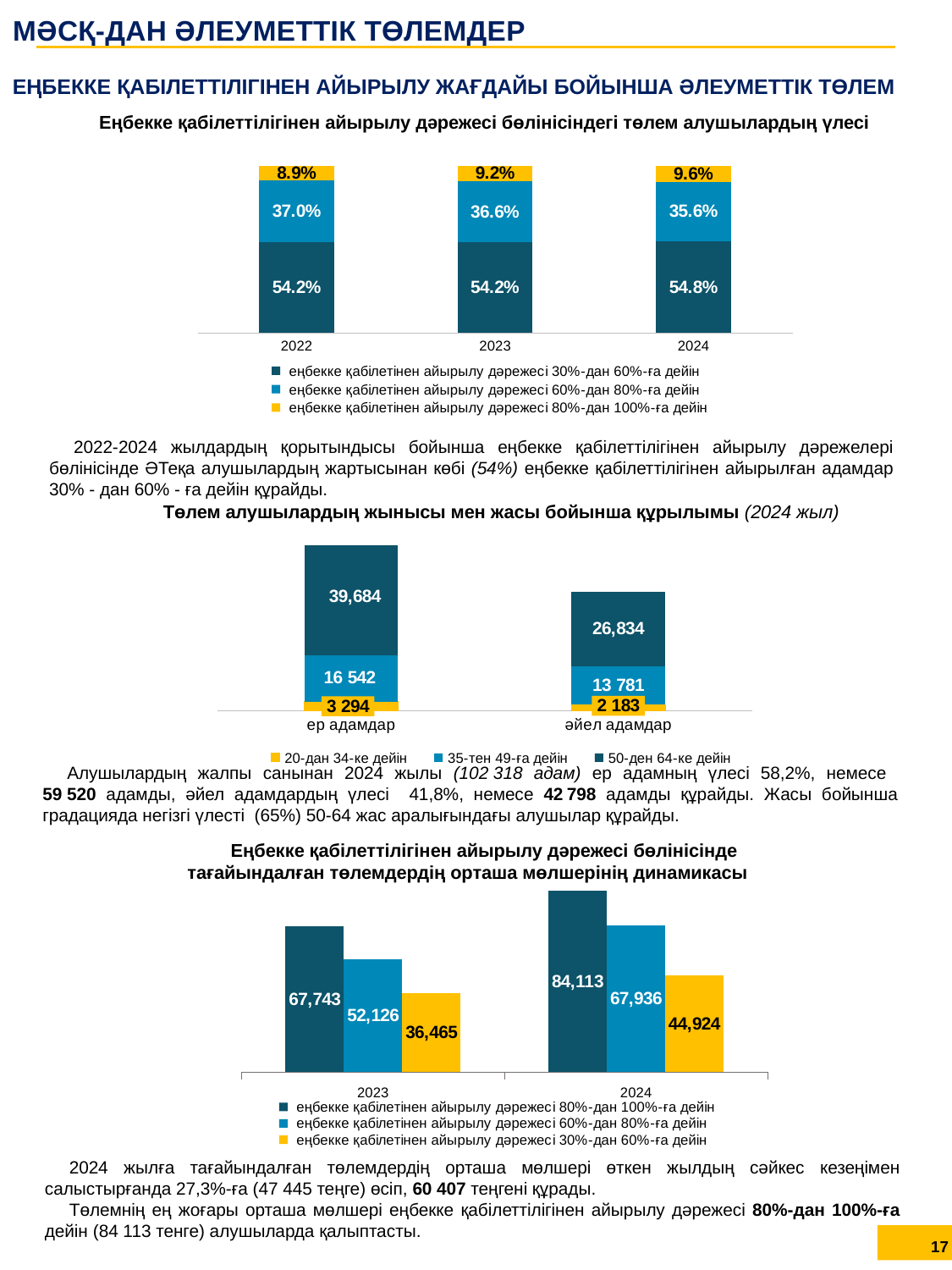
In the top chart (share of recipients by degree of loss of working capacity), how many series does the legend list? 3 In the bottom chart (dynamics of average payment size), what is the difference between the 60%-80% degree values in 2024 and 2023? 15,810 In the bottom chart (dynamics of average payment size), what is the value for the 80%-100% degree category in 2024? 84,113 In the middle chart (structure of recipients by sex and age, 2024), what is the value for the 50-64 age group among men (ер адамдар)? 39,684 In the top chart (share of recipients by degree of loss of working capacity), what is the value for the 80%-100% degree category in 2022? 8.9% In the top chart (share of recipients by degree of loss of working capacity), what kind of chart is it? Stacked bar chart In the middle chart (structure of recipients by sex and age, 2024), how many categories are shown on the x axis? 2 In the middle chart (structure of recipients by sex and age, 2024), what is the value for the 20-34 age group among women (әйел адамдар)? 2 183 In the bottom chart (dynamics of average payment size), which category has the lowest value in 2023? 30%-60% degree (36,465) In the top chart (share of recipients by degree of loss of working capacity), what is the value for the 30%-60% degree category in 2024? 54.8% In the middle chart (structure of recipients by sex and age, 2024), which is larger: the 35-49 age group for men or for women? Men (ер адамдар) In the top chart (share of recipients by degree of loss of working capacity), does the 80%-100% degree share rise or fall from 2022 to 2024? Rise